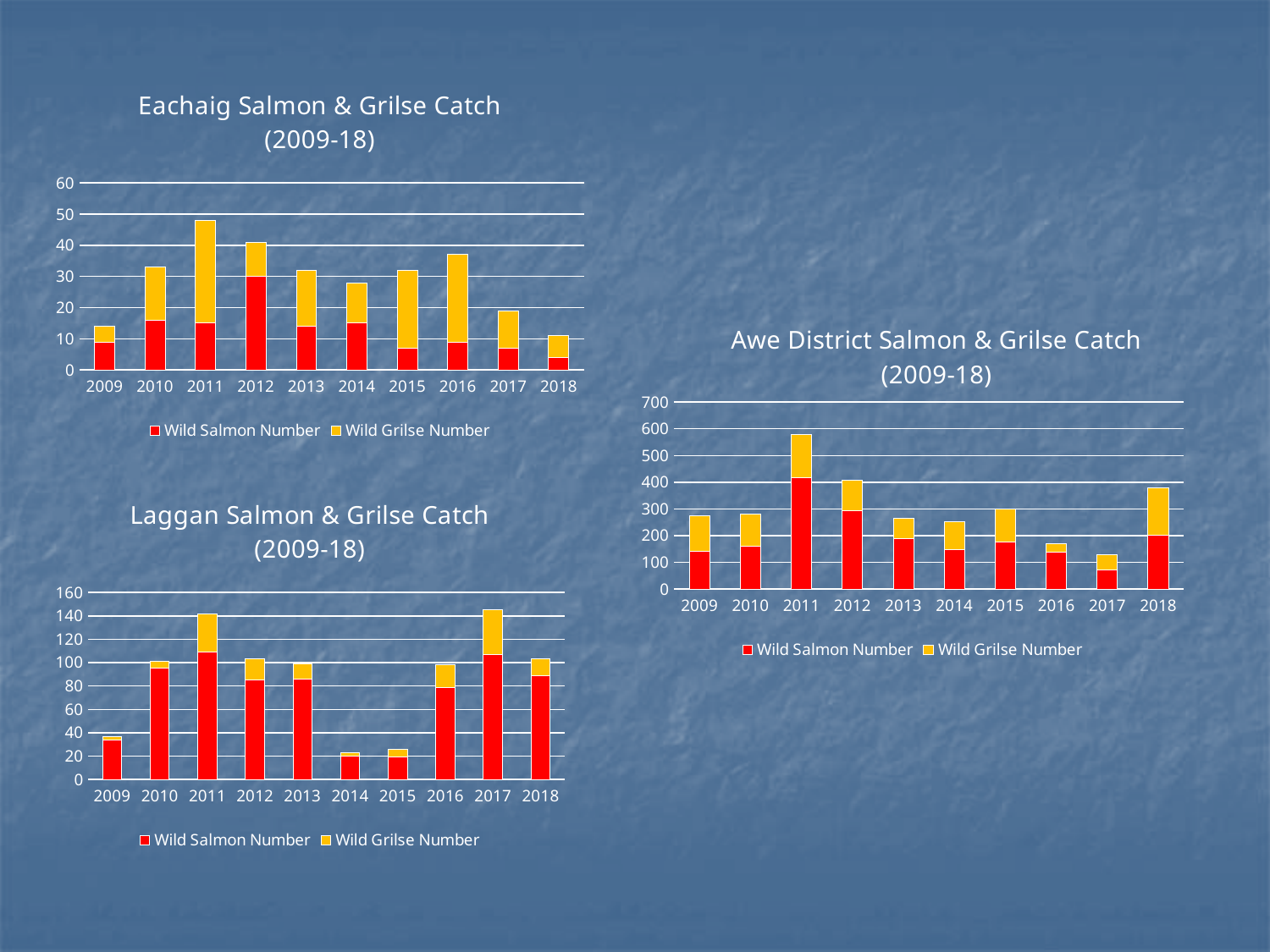
In the Awe District Salmon & Grilse Catch (2009-18) chart, which year has the highest total catch? 2011 How many series does the legend of the Awe District Salmon & Grilse Catch (2009-18) chart list? 2 What colour represents Wild Grilse Number in the Eachaig Salmon & Grilse Catch (2009-18) chart? yellow In the Laggan Salmon & Grilse Catch (2009-18) chart, is the total catch for 2017 greater or less than 2014? greater What type of chart is the Eachaig Salmon & Grilse Catch (2009-18) chart? stacked bar chart In the Eachaig Salmon & Grilse Catch (2009-18) chart, which year has the highest total catch? 2011 In the Awe District Salmon & Grilse Catch (2009-18) chart, is the total catch for 2011 greater or less than 500? greater How many years are shown on the x axis of the Laggan Salmon & Grilse Catch (2009-18) chart? 10 In the Eachaig Salmon & Grilse Catch (2009-18) chart, which year has the lowest total catch? 2018 In the Laggan Salmon & Grilse Catch (2009-18) chart, is the total catch for 2014 greater or less than 40? less In the Awe District Salmon & Grilse Catch (2009-18) chart, which year has the lowest total catch? 2017 In the Eachaig Salmon & Grilse Catch (2009-18) chart, is the total catch for 2011 greater or less than 40? greater